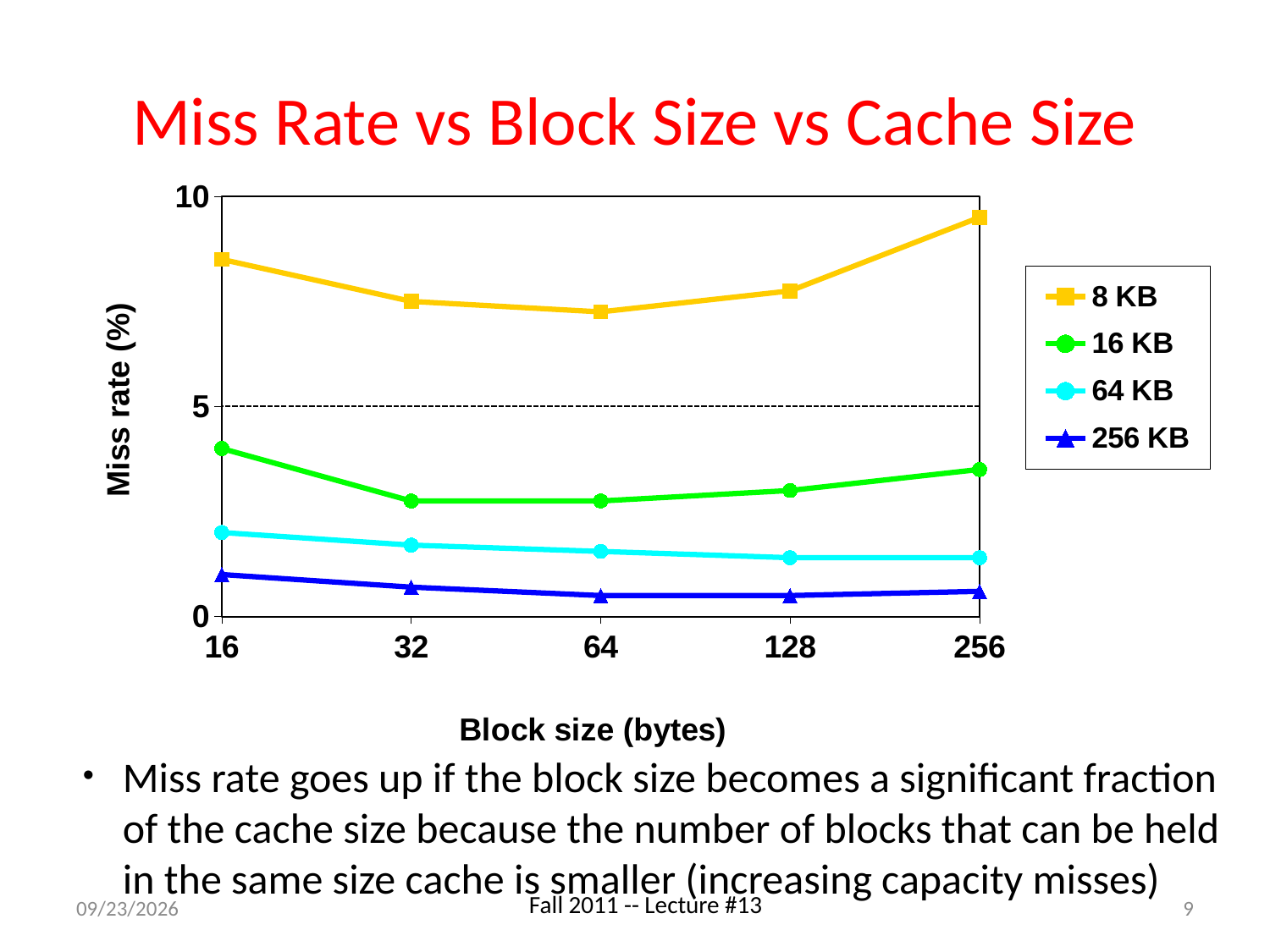
Which cache size series has the lowest miss rate across all block sizes? 256 KB Which cache size series has the highest miss rate across all block sizes? 8 KB For the 8 KB series, at which block size is the miss rate highest? 256 What is the label of the x axis? Block size (bytes) How many series does the legend list? 4 How many block sizes are plotted along the x axis? 5 Is the miss rate for the 16 KB series at block size 16 greater or less than 5? less For the 8 KB series, which is larger: the miss rate at block size 16 or at block size 256? block size 256 Is the miss rate for the 8 KB series at block size 256 greater or less than 5? greater For the 16 KB series, at which block size is the miss rate highest? 16 What kind of chart is shown on the slide? line chart Does the miss rate for the 64 KB series rise or fall as block size increases from 16 to 128? fall